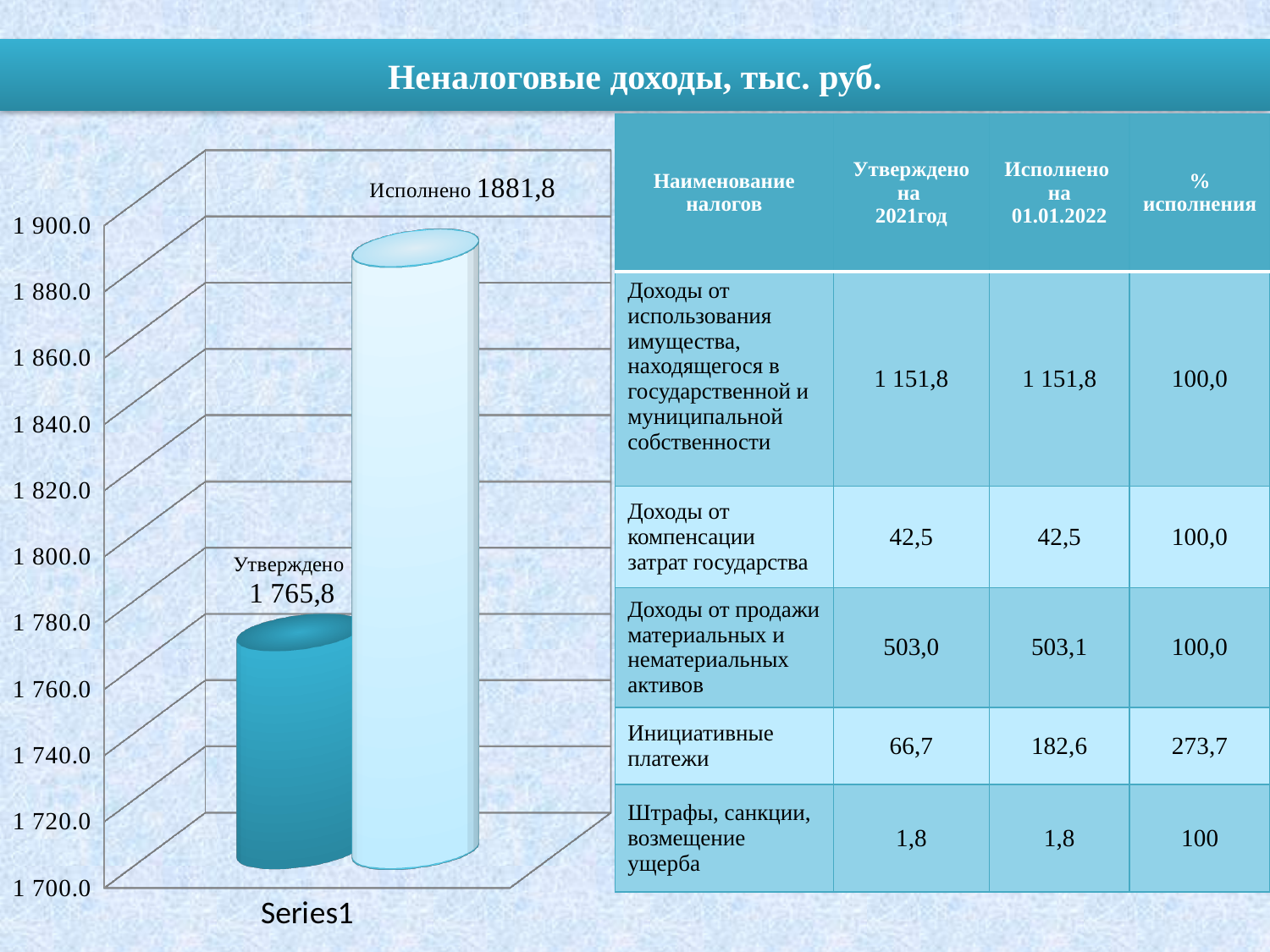
How many bars are plotted on the chart? 2 What is the title of the slide containing the chart? Неналоговые доходы, тыс. руб. Is the value for Исполнено greater or less than 1 860.0? greater What kind of chart is shown on the slide? bar chart What is the category label shown under the bars on the x axis? Series1 Is the value for Утверждено greater or less than 1 800.0? less What is the difference between the Исполнено and Утверждено values on the chart? 116,0 Which bar on the chart is the lowest? Утверждено Which bar on the chart is the highest? Исполнено Which is larger on the chart, Утверждено or Исполнено? Исполнено What is the value of the Исполнено bar on the chart? 1881,8 What is the value of the Утверждено bar on the chart? 1 765,8